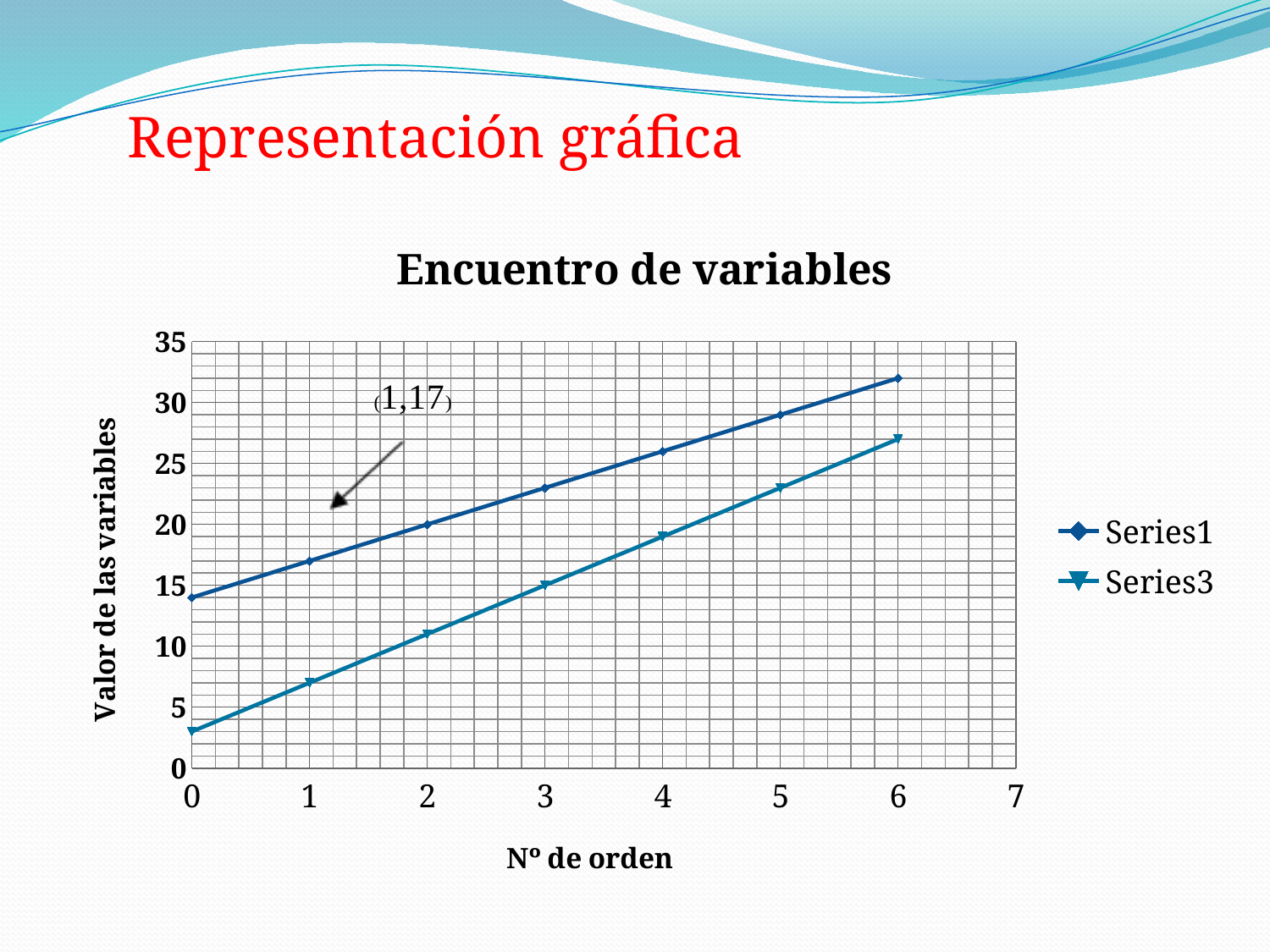
What type of chart is shown under the title "Encuentro de variables"? line chart What is the title of the chart? Encuentro de variables What are the names of the series in the legend? Series1 and Series3 What is the value of Series3 at Nº de orden 3? 15 What is the value of Series1 at Nº de orden 2? 20 How many series does the legend list? 2 Is the value of Series1 at Nº de orden 6 greater or less than 30? greater Is the value of Series3 at Nº de orden 0 greater or less than 5? less At Nº de orden 4, which series has the larger value, Series1 or Series3? Series1 What is the value of Series1 at Nº de orden 1, as marked by the annotation? 17 Do the values of Series3 rise or fall as Nº de orden increases? rise How many data points are plotted for Series1? 7